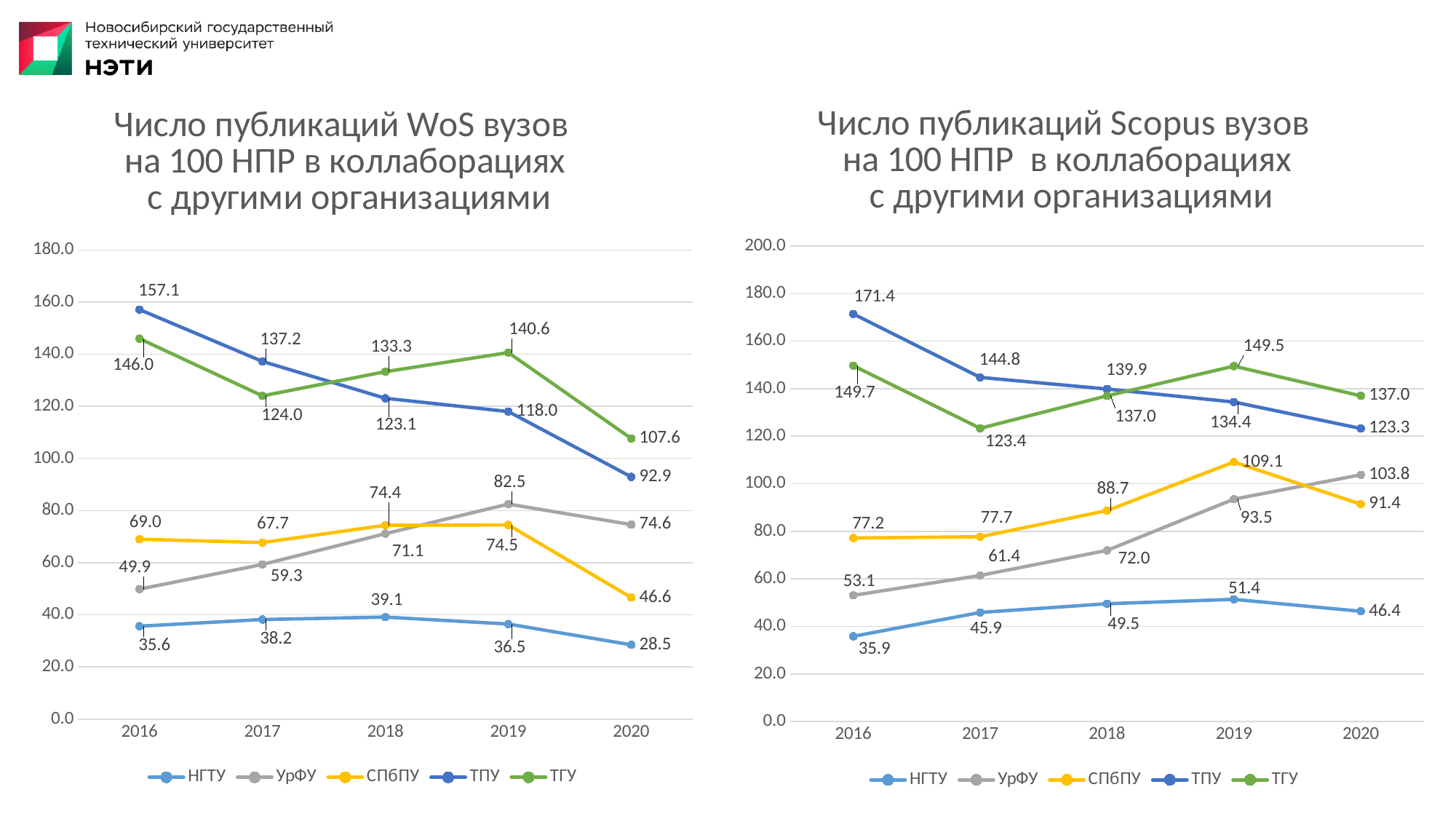
In the WoS chart (left), what is the difference between the ТПУ values in 2016 and 2020? 64.2 How many years are shown on the x axis of the WoS chart (left)? 5 In the WoS chart (left), what is the value for ТПУ in 2016? 157.1 In the Scopus chart (right), which is larger in 2019: the value for СПбПУ or the value for УрФУ? СПбПУ In the Scopus chart (right), is the value for ТПУ in 2016 greater or less than 160? greater In the WoS chart (left), which university has the highest value in 2020? ТГУ In the Scopus chart (right), which university has the lowest value in 2016? НГТУ What type of chart is the WoS chart (left)? Line chart In the WoS chart (left), what is the value for НГТУ in 2018? 39.1 In the Scopus chart (right), what is the value for УрФУ in 2020? 103.8 How many series does the legend of the Scopus chart (right) list? 5 In the Scopus chart (right), does the value for ТПУ rise or fall from 2016 to 2020? Fall